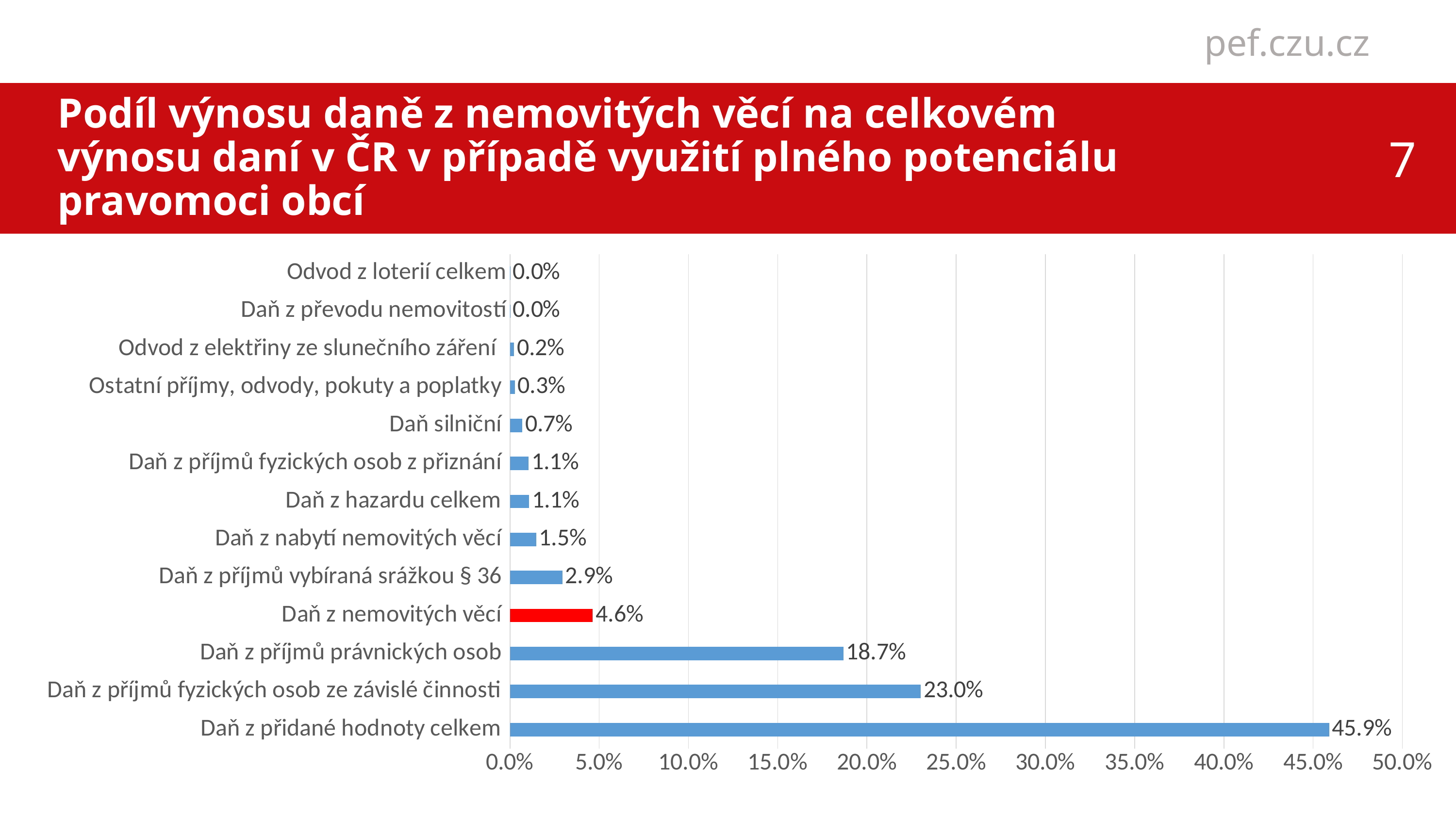
What is the value for Daň z nemovitých věcí? 4.6% What is the value for Daň z nabytí nemovitých věcí? 1.5% What is the value for Daň z příjmů právnických osob? 18.7% What is the difference between Daň z přidané hodnoty celkem and Daň z příjmů fyzických osob ze závislé činnosti? 22.9% Which category has the highest value? Daň z přidané hodnoty celkem Which bar is coloured red instead of blue? Daň z nemovitých věcí What is the difference between Daň z nemovitých věcí and Daň z příjmů vybíraná srážkou § 36? 1.7% How many categories are shown in the chart? 13 What is the value for Daň silniční? 0.7% What kind of chart is shown on the slide? bar chart Is the value for Daň z přidané hodnoty celkem greater or less than 40.0%? greater Which is larger, Daň z příjmů právnických osob or Daň z příjmů fyzických osob ze závislé činnosti? Daň z příjmů fyzických osob ze závislé činnosti